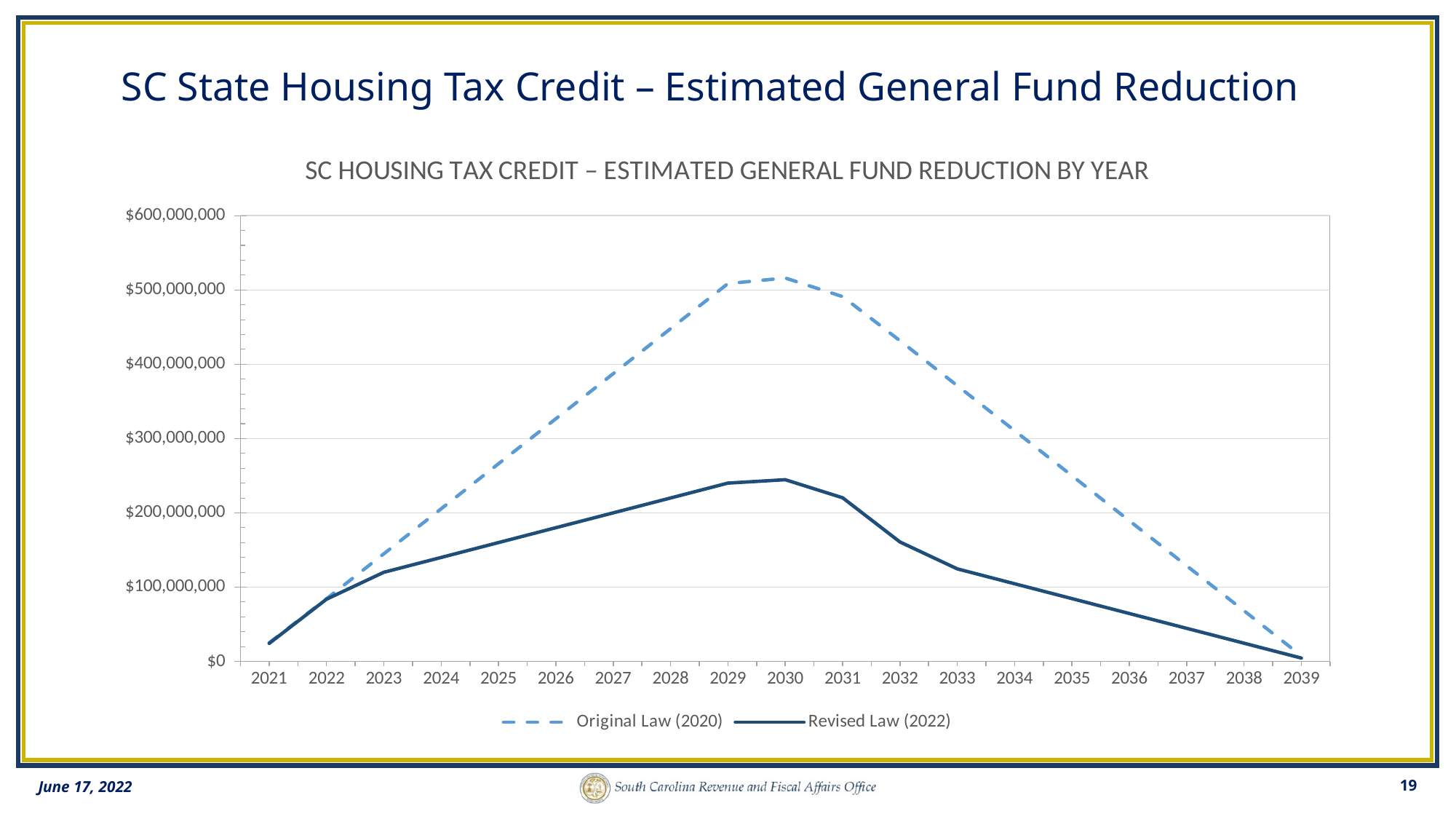
How many years are plotted along the x axis? 19 How many series does the legend list? 2 Is the value for Revised Law (2022) in 2021 greater or less than $100,000,000? less Is the value for Original Law (2020) in 2029 greater or less than $400,000,000? greater Does the Original Law (2020) series rise or fall from 2021 to 2030? Rise In which year is the Revised Law (2022) value lowest? 2039 Is the value for Revised Law (2022) in 2030 greater or less than $300,000,000? less Does the Revised Law (2022) series rise or fall from 2030 to 2039? Fall What kind of chart is shown on the slide? Line chart In 2030, which series has the higher value, Original Law (2020) or Revised Law (2022)? Original Law (2020) Which series is drawn with a dashed line? Original Law (2020) What are the two series named in the legend? Original Law (2020) and Revised Law (2022)